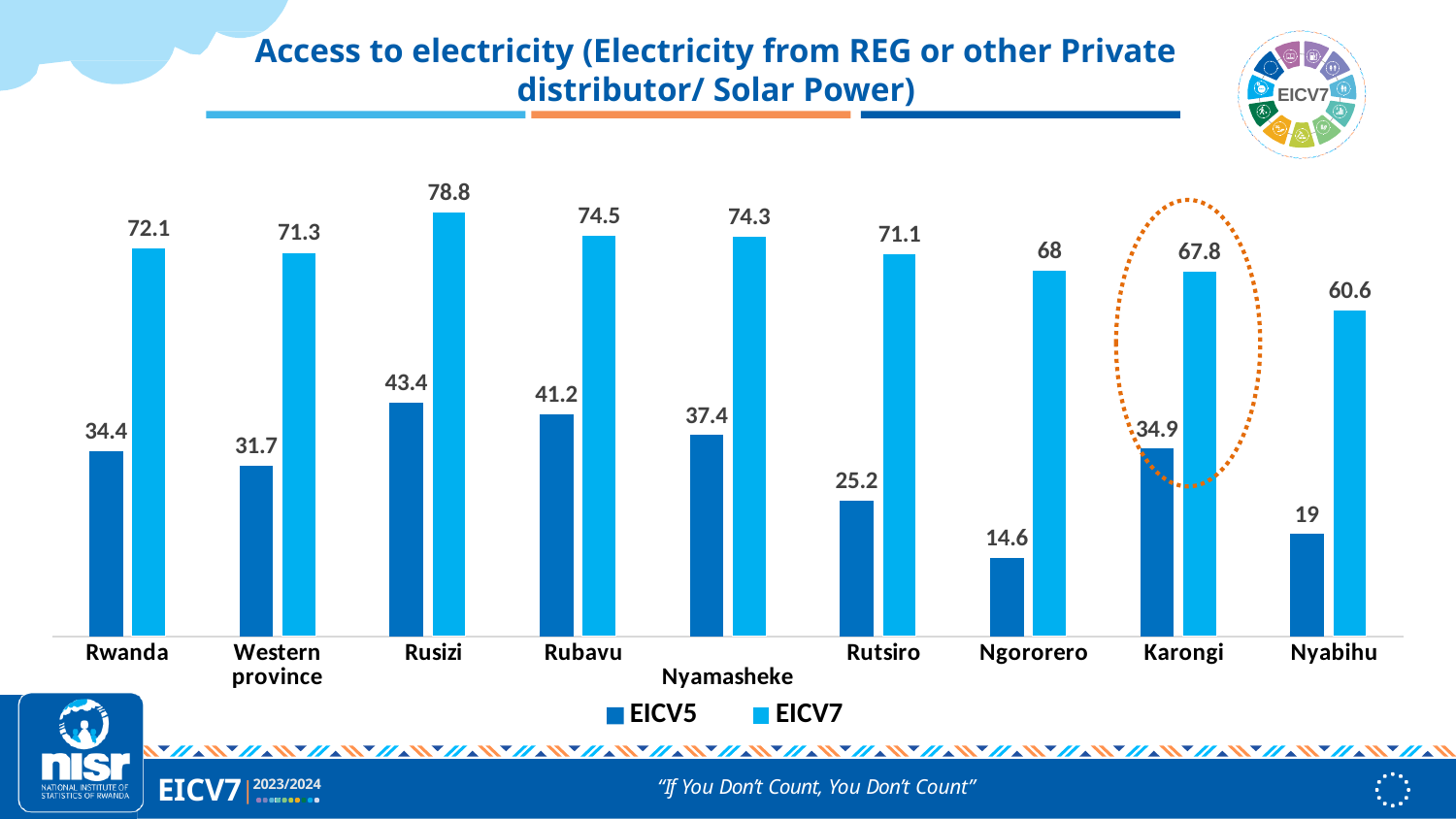
What kind of chart is shown on the slide? Bar chart How many series does the legend list? 2 Which category has the highest EICV7 value? Rusizi What is the EICV7 value for Karongi? 67.8 Which is larger, the EICV5 value for Rusizi or the EICV5 value for Rubavu? Rusizi Which category has the lowest EICV5 value? Ngororero Which category is highlighted with a dotted orange circle? Karongi What is the EICV5 value for Ngororero? 14.6 How many categories are shown on the x axis? 9 What is the EICV7 value for Rusizi? 78.8 What is the difference between the EICV7 and EICV5 values for Nyabihu? 41.6 What is the EICV5 value for Rwanda? 34.4